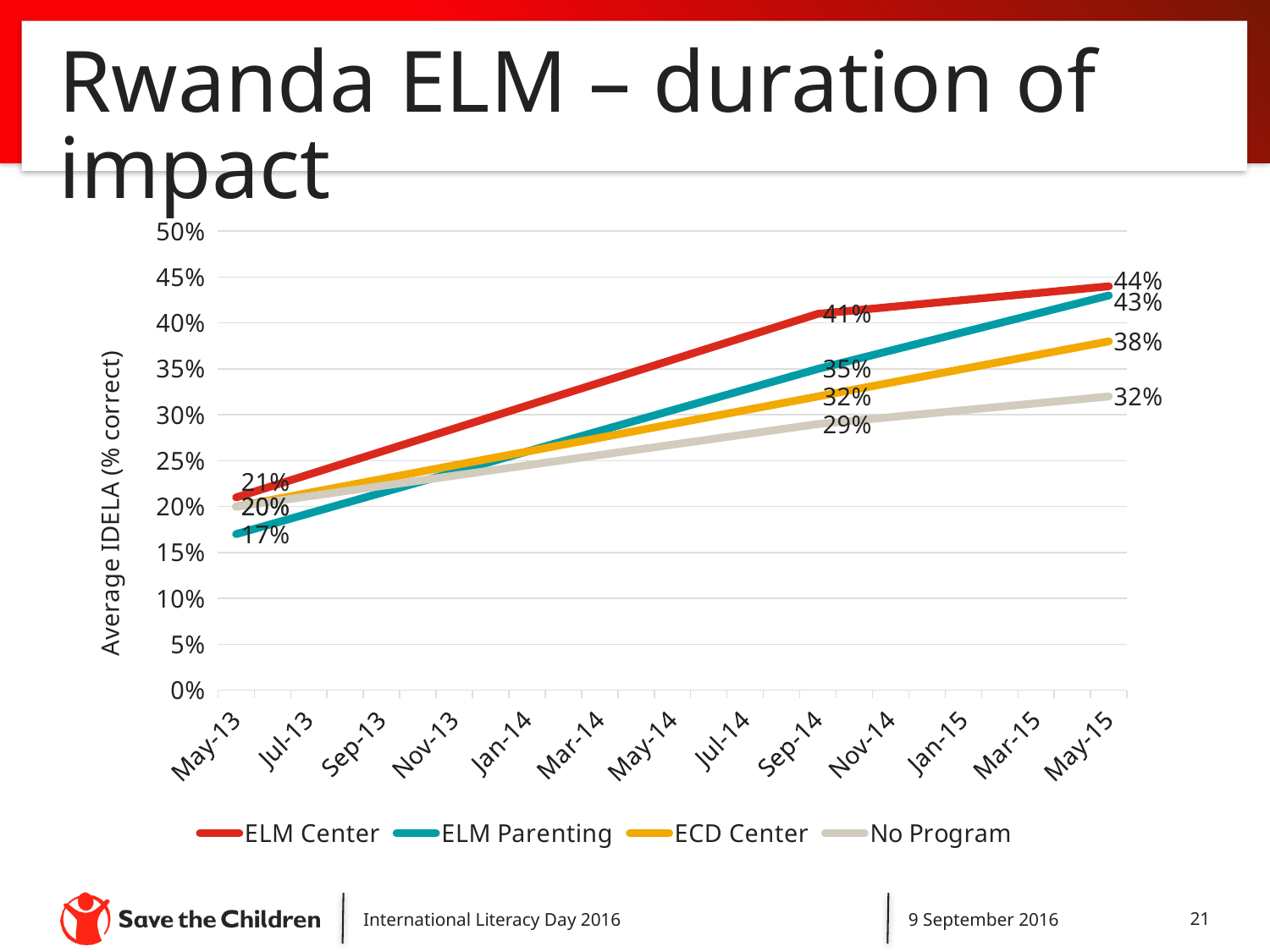
What is the difference between ELM Center and No Program at May-15? 12 percentage points Which series has the highest value at May-15? ELM Center By how much did ELM Parenting increase from May-13 to May-15? 26 percentage points Does the ELM Parenting line rise or fall from May-13 to May-15? rise What is the value for ELM Center at May-15? 44% What kind of chart is shown on the slide? line chart Which series has the lowest value at Sep-14? No Program What is the value for No Program at Sep-14? 29% At Sep-14, which is larger: ECD Center or No Program? ECD Center What is the value for ELM Parenting at May-13? 17% What is the value for ECD Center at May-15? 38% How many series does the legend list? 4